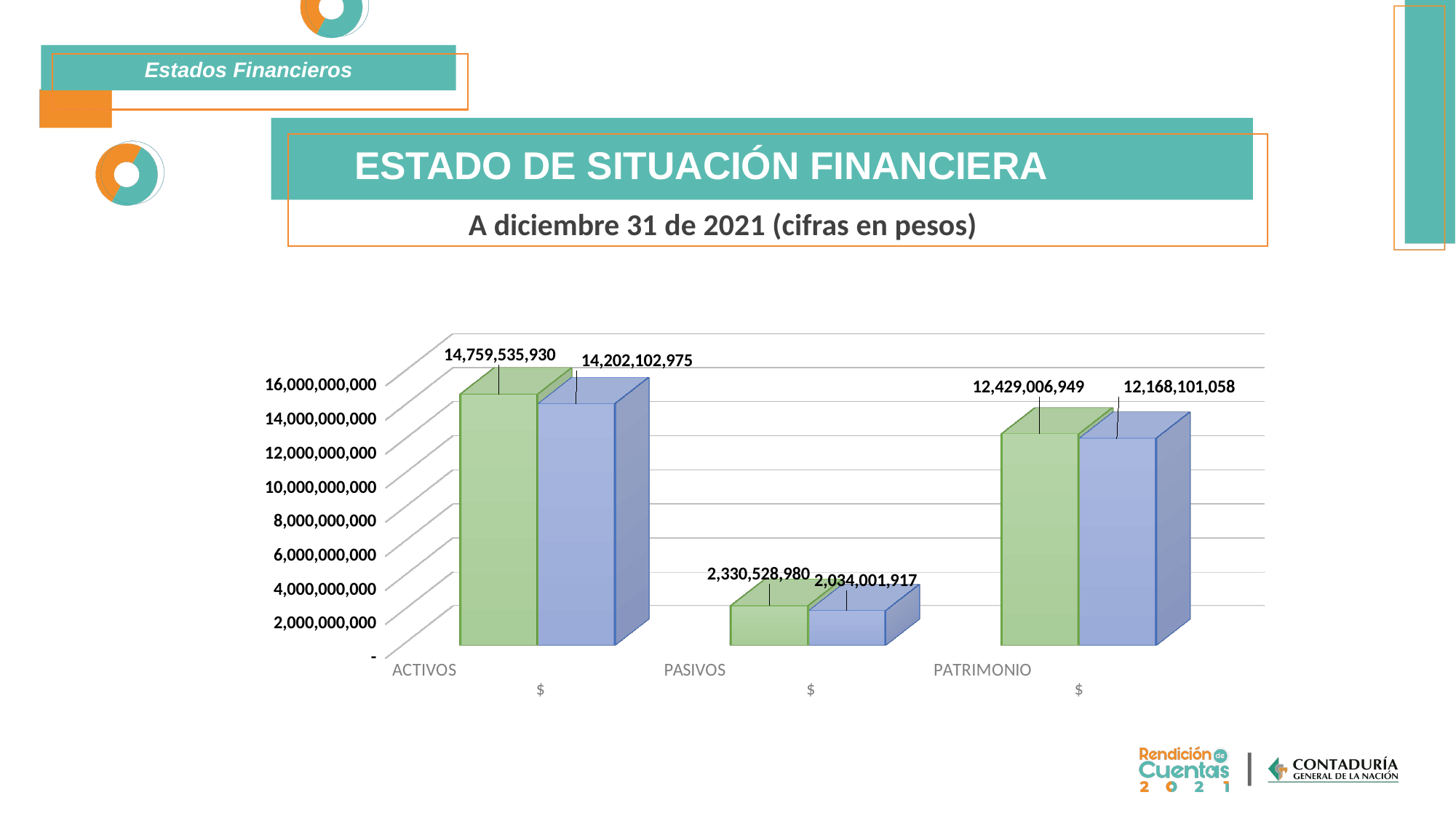
What is the value of the green bar for PASIVOS? 2,330,528,980 Which category has the highest green bar? ACTIVOS Which is larger for PATRIMONIO, the green bar or the blue bar? the green bar What kind of chart is shown on the slide? bar chart What is the value of the green bar for ACTIVOS? 14,759,535,930 What is the difference between the green and blue bars for PASIVOS? 296,527,063 What is the value of the blue bar for PATRIMONIO? 12,168,101,058 How many categories are shown on the x axis of the chart? 3 What is the value of the blue bar for ACTIVOS? 14,202,102,975 Is the blue bar for PASIVOS greater or less than 4,000,000,000? less What is the difference between the green and blue bars for ACTIVOS? 557,432,955 Which category has the lowest values in the chart? PASIVOS